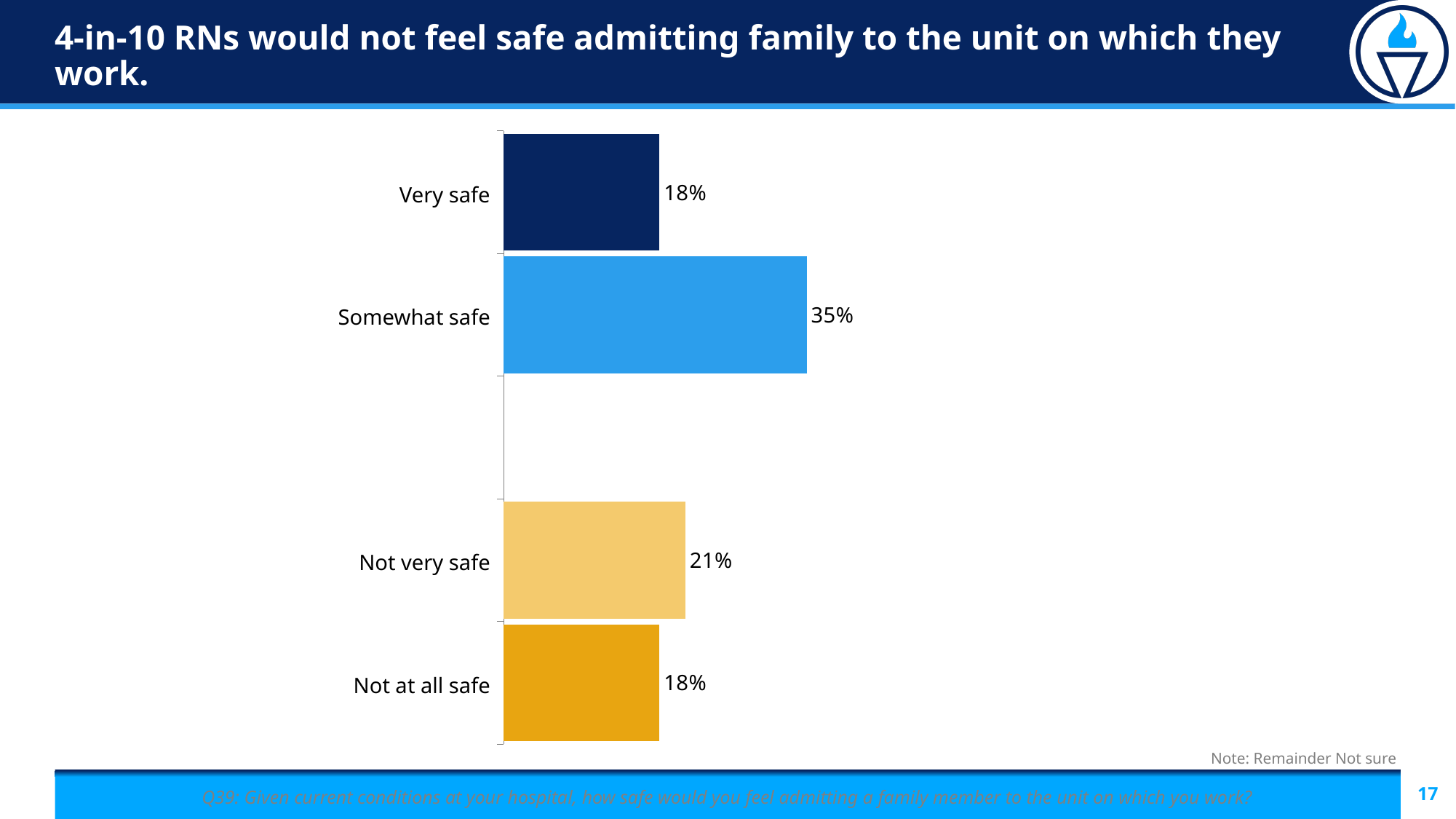
What percentage of RNs said they would feel very safe admitting a family member to their unit? 18% What type of chart is shown on the slide? Bar chart What is the value shown for 'Somewhat safe'? 35% What is the value for 'Not at all safe'? 18% Which response category has the highest percentage? Somewhat safe What percentage of RNs answered 'Not very safe'? 21% How many response categories are shown in the chart? 4 What is the difference between the 'Not very safe' and 'Very safe' values? 3% What is the combined percentage of RNs who answered 'Not very safe' or 'Not at all safe'? 39% According to the note on the slide, what does the remainder of responses represent? Not sure What is the difference between the 'Somewhat safe' and 'Not very safe' percentages? 14% Which is larger, the value for 'Somewhat safe' or the value for 'Not very safe'? Somewhat safe